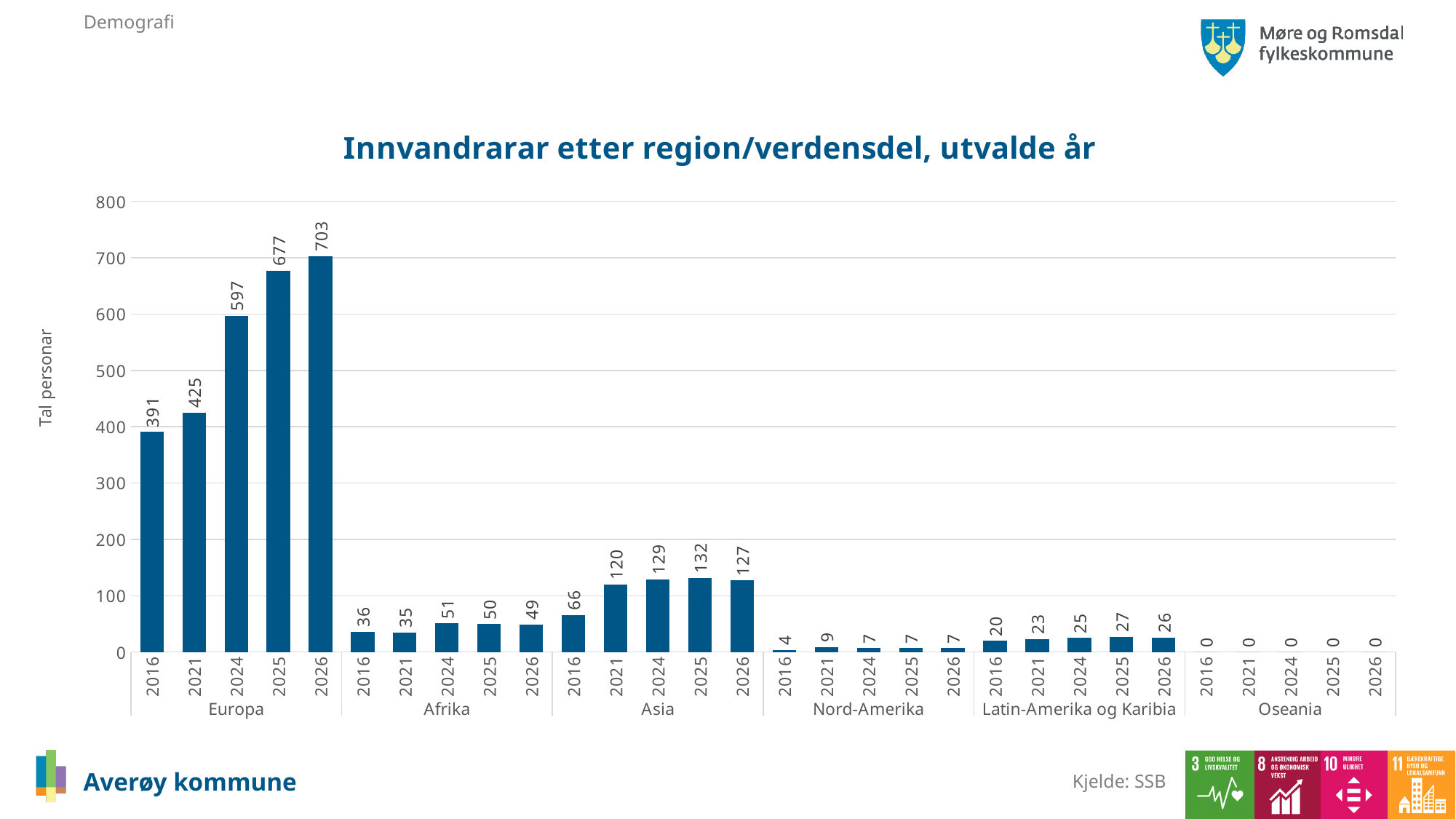
What is the value for Asia in 2021? 120 Is the value for Europa in 2025 greater or less than 600? greater Which region has the highest value in 2026? Europa What is the value for Nord-Amerika in 2016? 4 Do the values for Latin-Amerika og Karibia rise or fall from 2016 to 2025? Rise Which is larger: the value for Asia in 2025 or the value for Asia in 2026? Asia in 2025 Which region has the lowest value in 2016? Oseania How many regions are shown on the x axis? 6 What is the value for Afrika in 2024? 51 What is the value for Europa in 2026? 703 What kind of chart is shown on the slide? Bar chart What is the difference between the Europa values for 2026 and 2016? 312